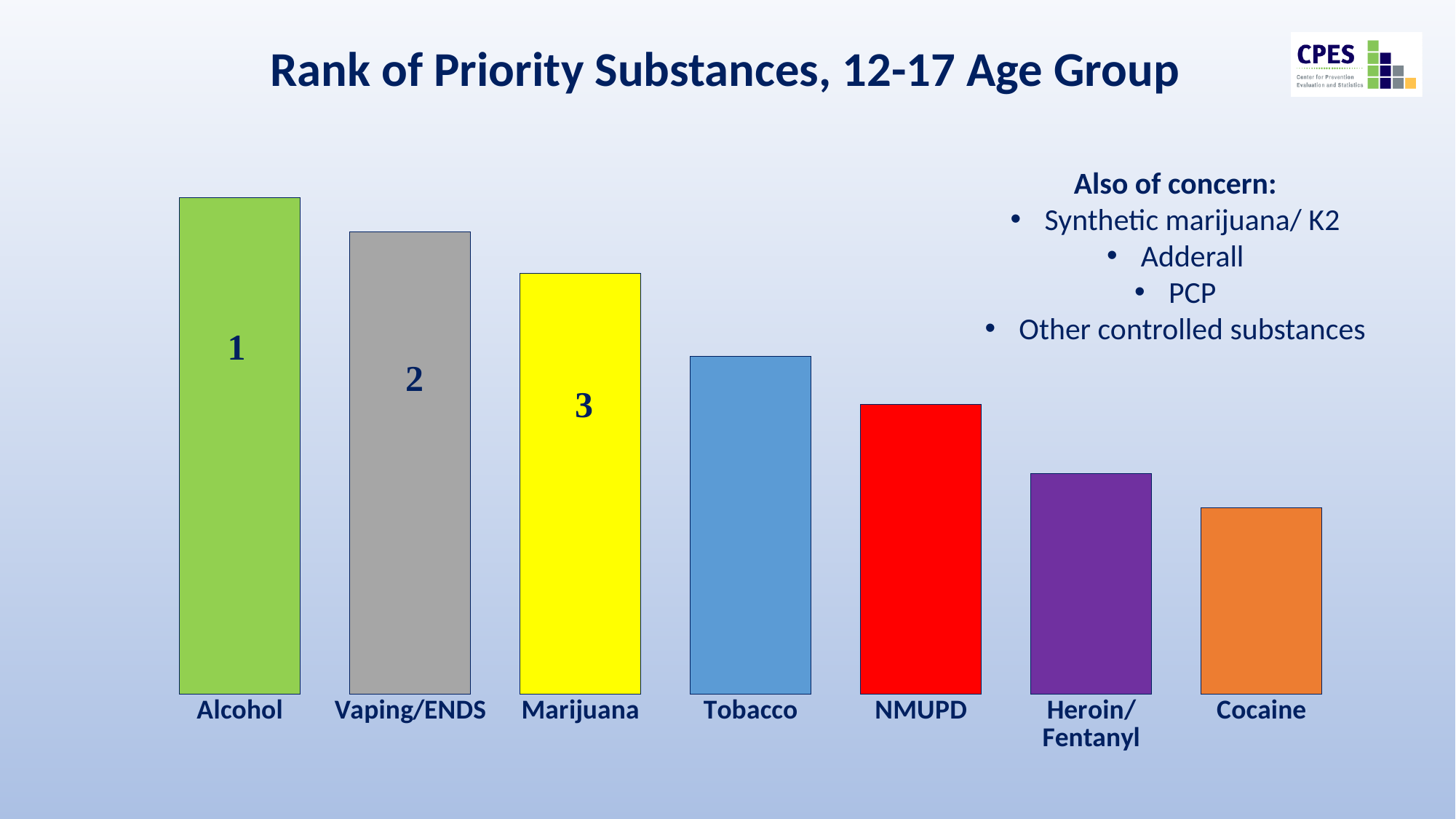
How many substances (bars) are shown in the chart? 7 Which substance has the tallest bar in the chart? Alcohol What rank number is printed on the Vaping/ENDS bar? 2 Which bar is taller, Tobacco or NMUPD? Tobacco What type of chart is shown on the slide? Bar chart Which substance is labelled with rank 3? Marijuana Which substance has the shortest bar in the chart? Cocaine Do the bar heights rise or fall moving from left to right across the chart? Fall What is the title of the chart? Rank of Priority Substances, 12-17 Age Group Which bar is taller, Heroin/Fentanyl or Cocaine? Heroin/Fentanyl What colour is the Marijuana bar? Yellow What rank number is printed on the Alcohol bar? 1